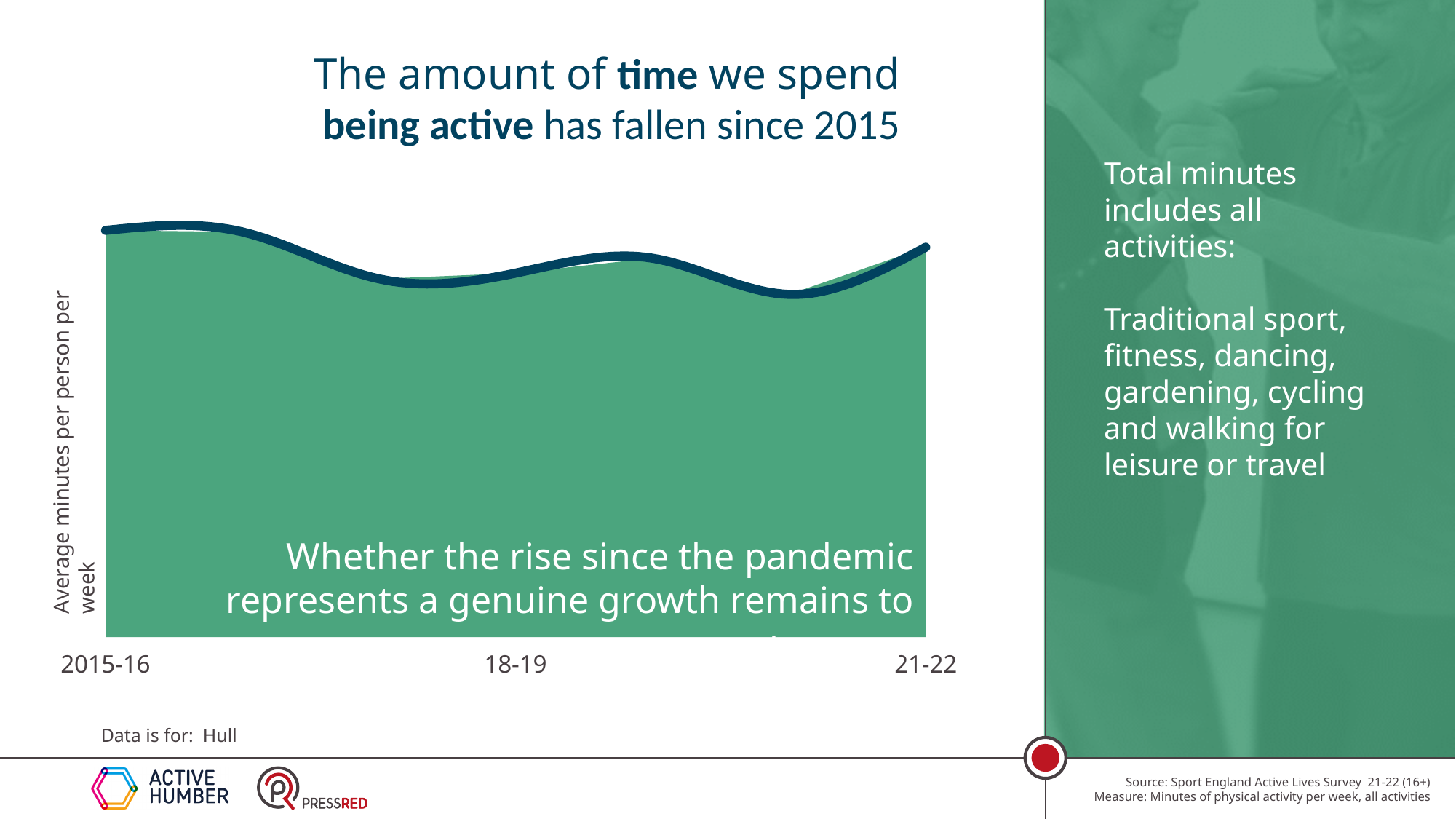
Which is larger, the value for 2015-16 or the value for 18-19? 2015-16 Which is larger, the value for 2015-16 or the value for 21-22? 2015-16 Overall, do the values rise or fall from 2015-16 to 21-22? Fall Which area is the chart's data for? Hull Which labelled year on the x axis has the highest value? 2015-16 What kind of chart is shown on the slide? Area chart Do the values rise or fall between 2015-16 and 18-19? Fall What is the label on the y axis? Average minutes per person per week How many year labels are shown on the x axis? 3